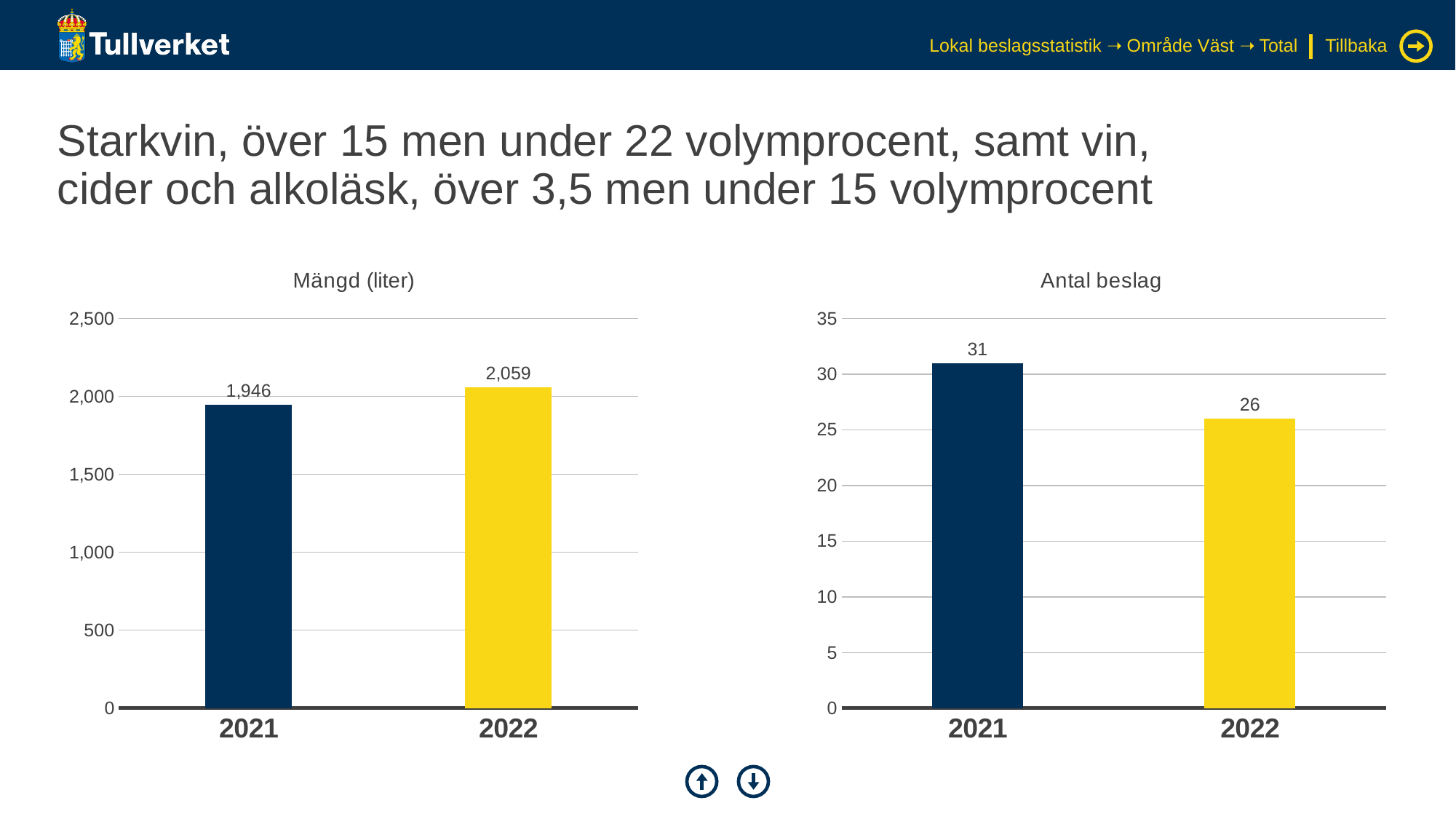
In the 'Antal beslag' chart, which year has the lowest value? 2022 In the 'Antal beslag' chart, what is the difference between the 2021 and 2022 values? 5 In the 'Mängd (liter)' chart, what is the value for 2022? 2,059 In the 'Mängd (liter)' chart, what is the value for 2021? 1,946 In the 'Antal beslag' chart, is the value for 2021 greater or less than 30? greater In the 'Antal beslag' chart, what is the value for 2022? 26 In the 'Mängd (liter)' chart, how many years are shown? 2 In the 'Antal beslag' chart, do the values rise or fall from 2021 to 2022? fall In the 'Antal beslag' chart, what is the value for 2021? 31 In the 'Mängd (liter)' chart, what is the difference between the 2022 and 2021 values? 113 What kind of chart is the 'Antal beslag' chart? bar chart In the 'Mängd (liter)' chart, which year has the highest value? 2022